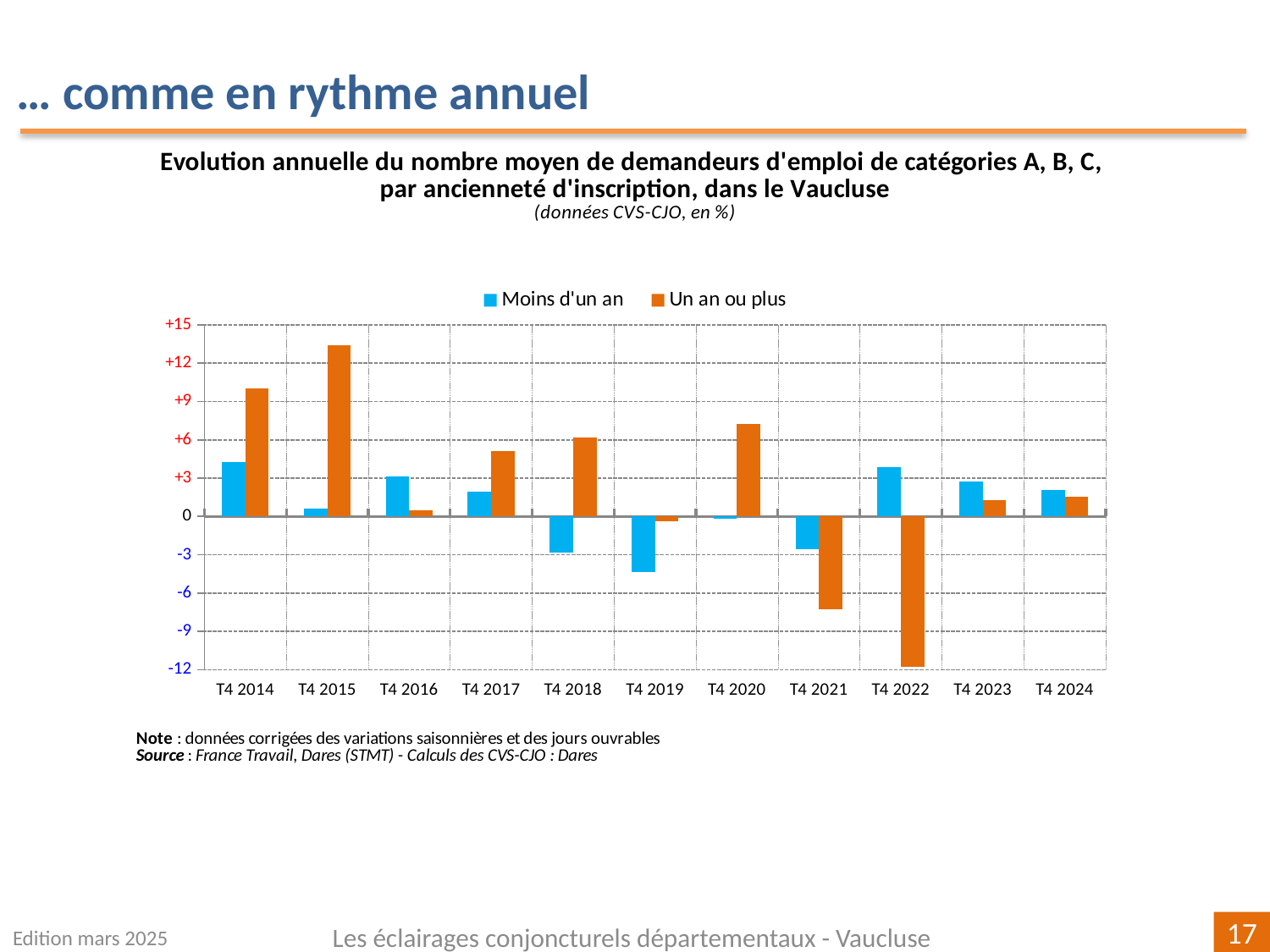
In which quarter is the value for 'Un an ou plus' the highest? T4 2015 In T4 2022, which series has the larger value, 'Moins d'un an' or 'Un an ou plus'? Moins d'un an Is the value for 'Un an ou plus' in T4 2015 greater or less than +12? greater What colour represents the 'Moins d'un an' series in the legend? Blue Is the value for 'Un an ou plus' in T4 2022 greater or less than -9? less In T4 2018, which series has the larger value, 'Moins d'un an' or 'Un an ou plus'? Un an ou plus In which quarter is the value for 'Moins d'un an' the highest? T4 2014 What kind of chart is shown on the slide? Bar chart In which quarter is the value for 'Un an ou plus' the lowest? T4 2022 How many series does the legend list? 2 How many quarters (categories) are shown on the x axis? 11 In which quarter is the value for 'Moins d'un an' the lowest? T4 2019